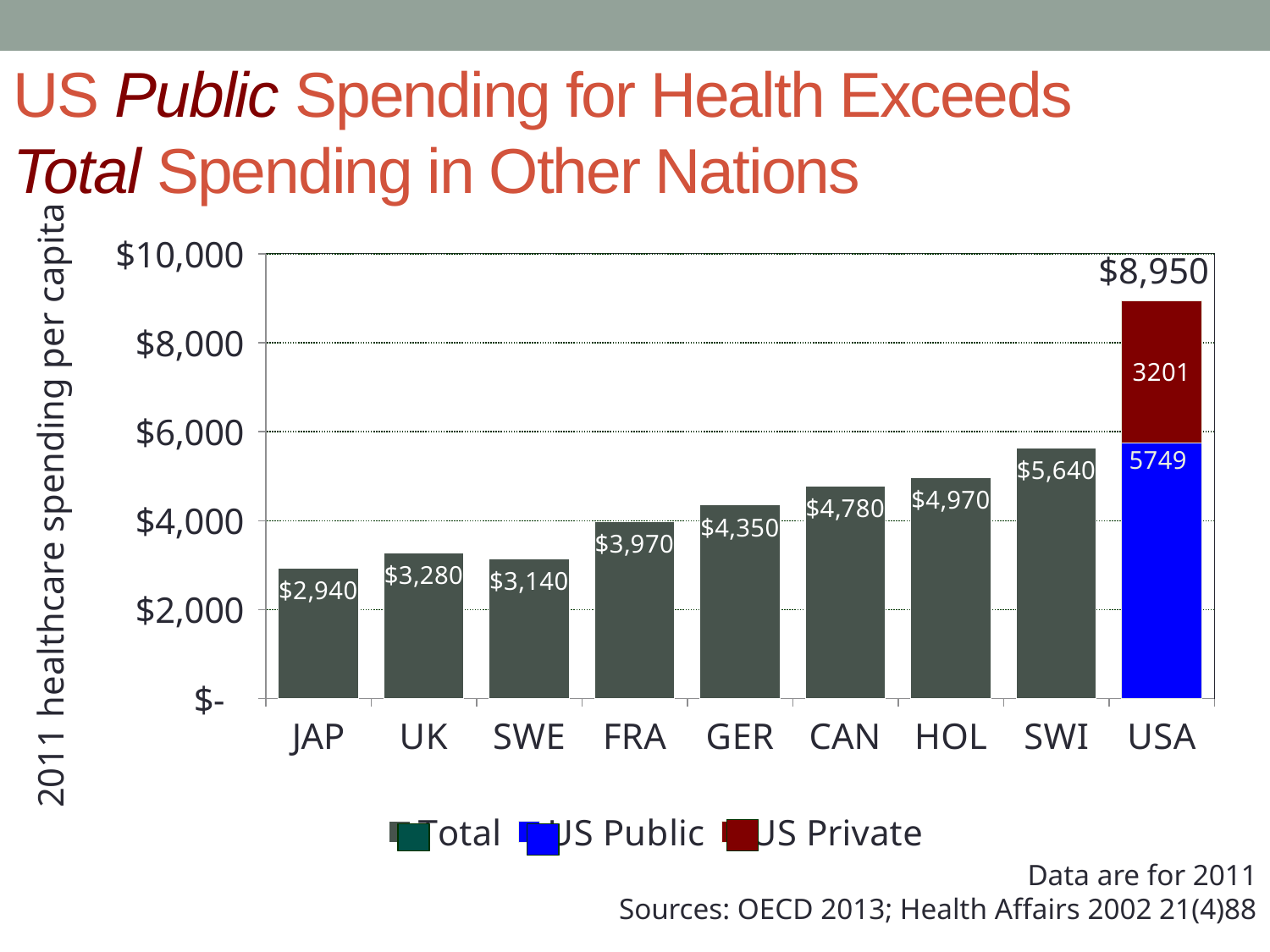
What is the US Public spending value shown on the USA bar? 5749 How many countries are shown on the x axis? 9 What is the 2011 healthcare spending per capita for Japan (JAP)? $2,940 What is the US Private spending value shown on the USA bar? 3201 Which country has the lowest healthcare spending per capita? JAP What kind of chart is shown on the slide? Bar chart What is the difference between the values for Germany (GER) and France (FRA)? $380 Which country has the highest total healthcare spending per capita? USA Which has a higher value, UK or SWE? UK What is the total of the USA stacked bar? $8,950 How many series does the legend list? 3 What is the value shown for Switzerland (SWI)? $5,640